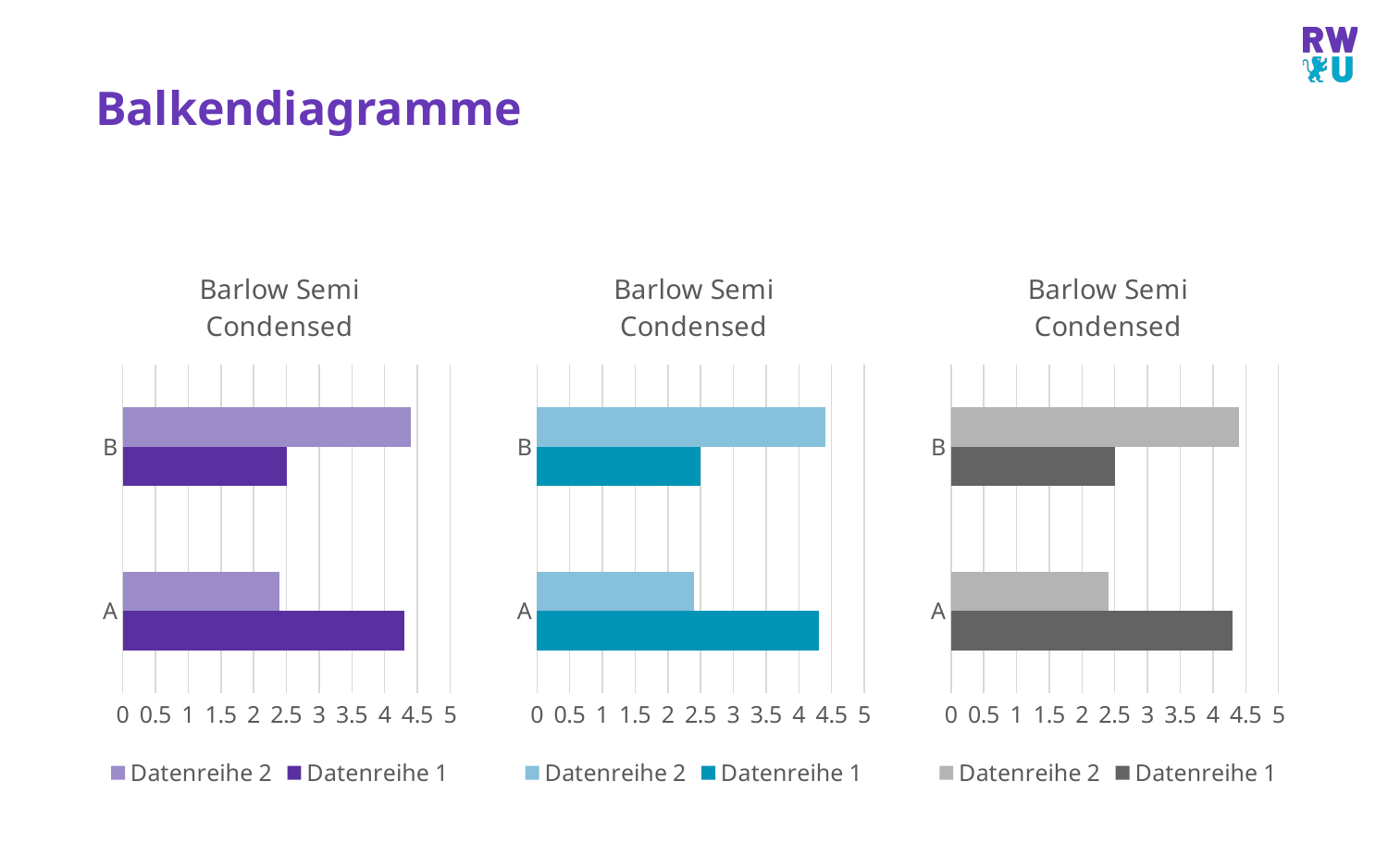
In the middle chart, which category has the higher value for Datenreihe 2, A or B? B In the left chart, is the value of Datenreihe 1 for A greater or less than 4? greater In the right chart, for category B, which series has the larger value? Datenreihe 2 In the left chart, is the value of Datenreihe 1 for B greater or less than 3? less What kind of chart is the left chart? bar chart What is the title of the middle chart? Barlow Semi Condensed In the middle chart, is the value of Datenreihe 2 for A greater or less than 3? less In the left chart, which category has the higher value for Datenreihe 1, A or B? A How many series does the legend of the middle chart list? 2 How many categories are shown on the right chart? 2 What is the maximum value shown on the x axis of the right chart? 5